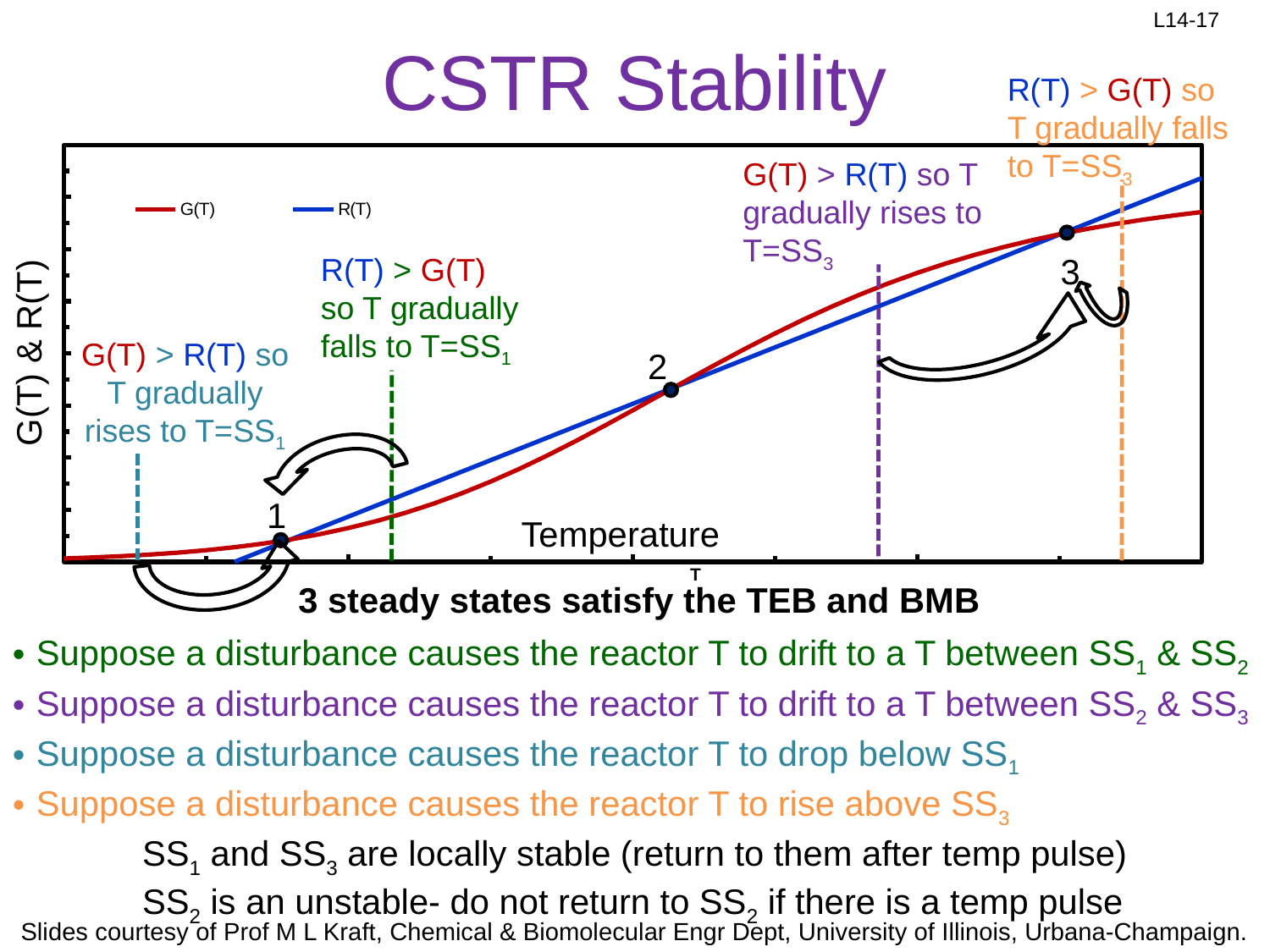
At temperatures above steady state 3, which series has the larger value, G(T) or R(T)? R(T) What kind of chart is shown on the slide? line chart What is the label on the vertical axis of the chart? G(T) & R(T) How many steady-state intersection points are marked on the chart? 3 Which of the three marked steady states is at the highest temperature? 3 What are the two series named in the chart legend? G(T) and R(T) Does the R(T) line rise or fall as temperature increases along the x axis? rises Between steady states 1 and 2, which series has the larger value, G(T) or R(T)? R(T) Between steady states 2 and 3, which series has the larger value, G(T) or R(T)? G(T) Which of the three marked steady states is at the lowest temperature? 1 How many series does the chart legend list? 2 Does the G(T) curve rise or fall as temperature increases along the x axis? rises